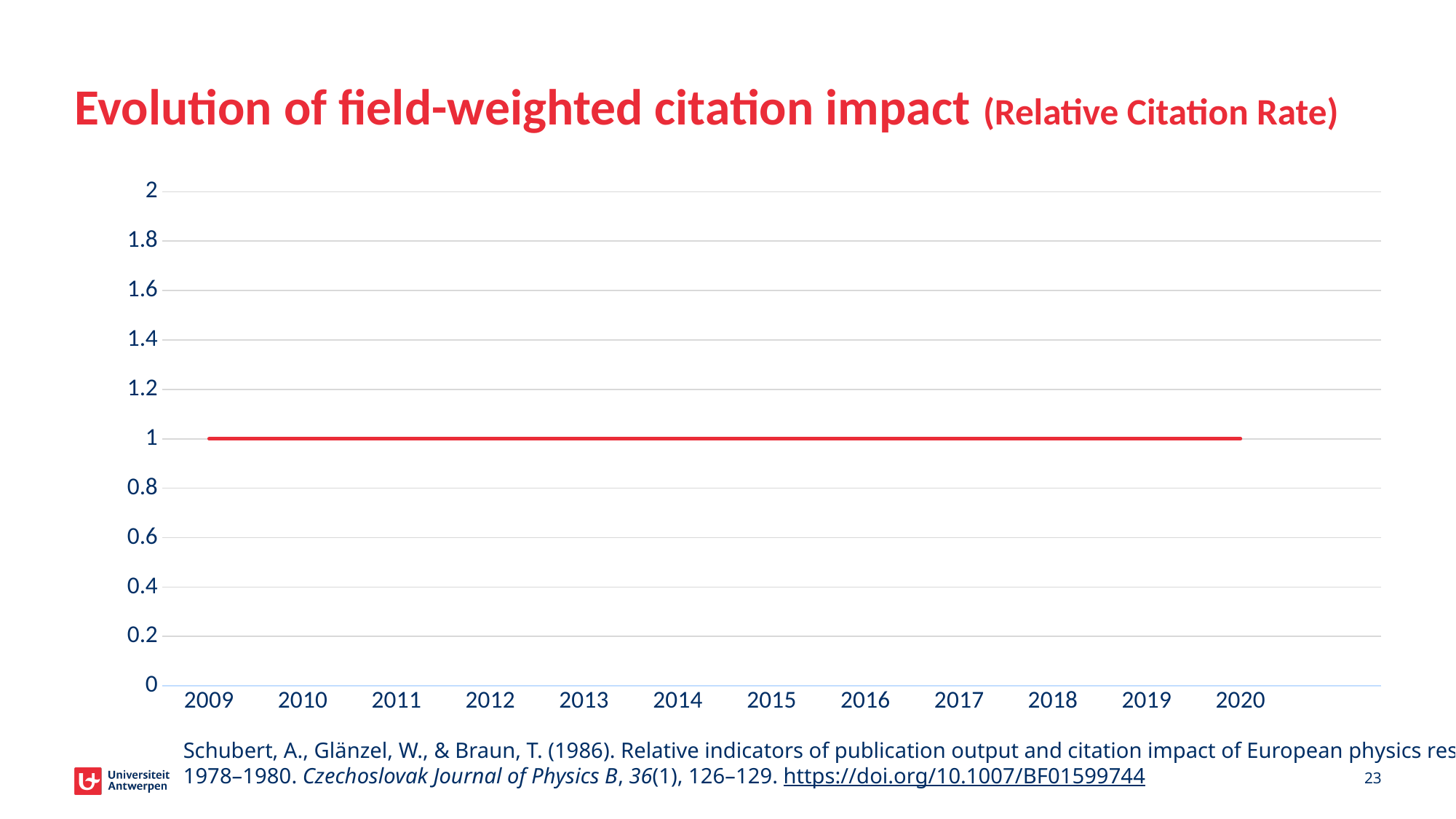
Do the values rise, fall or stay flat from 2009 to 2020? stay flat What is the first year shown on the x axis? 2009 What is the value of the line in 2020? 1 What kind of chart is shown on the slide? line chart Is the value for 2018 greater or less than 0.8? greater Is the value for 2012 greater or less than 1.2? less What is the difference between the values for 2009 and 2020? 0 What is the value of the line in 2015? 1 What is the highest value labelled on the y axis? 2 How many years are labelled on the x axis? 12 What is the value of the line in 2009? 1